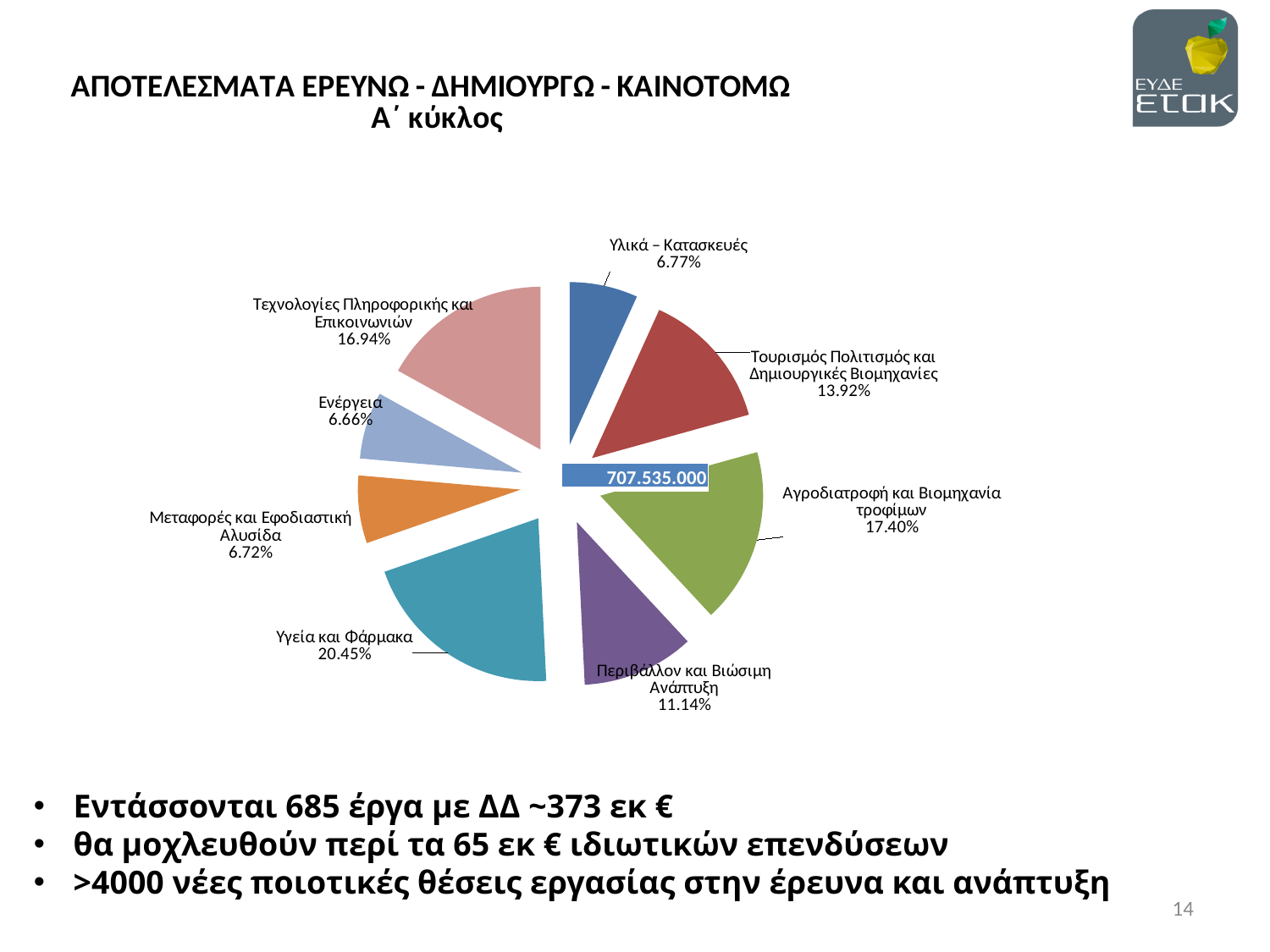
What value is printed in the centre of the pie chart? 707.535.000 What is the difference in percentage points between Υγεία και Φάρμακα and Αγροδιατροφή και Βιομηχανία τροφίμων? 3.05 percentage points How many slices does the pie chart have? 8 What share of the pie does Υγεία και Φάρμακα have? 20.45% Which is larger: the share for Τουρισμός Πολιτισμός και Δημιουργικές Βιομηχανίες or the share for Περιβάλλον και Βιώσιμη Ανάπτυξη? Τουρισμός Πολιτισμός και Δημιουργικές Βιομηχανίες What percentage is shown for Μεταφορές και Εφοδιαστική Αλυσίδα? 6.72% Which category has the smallest slice of the pie? Ενέργεια What percentage is shown for Περιβάλλον και Βιώσιμη Ανάπτυξη? 11.14% What kind of chart is shown on the slide? Pie chart What percentage is shown for Τεχνολογίες Πληροφορικής και Επικοινωνιών? 16.94% What percentage is shown for Αγροδιατροφή και Βιομηχανία τροφίμων? 17.40% Which category has the largest slice of the pie? Υγεία και Φάρμακα